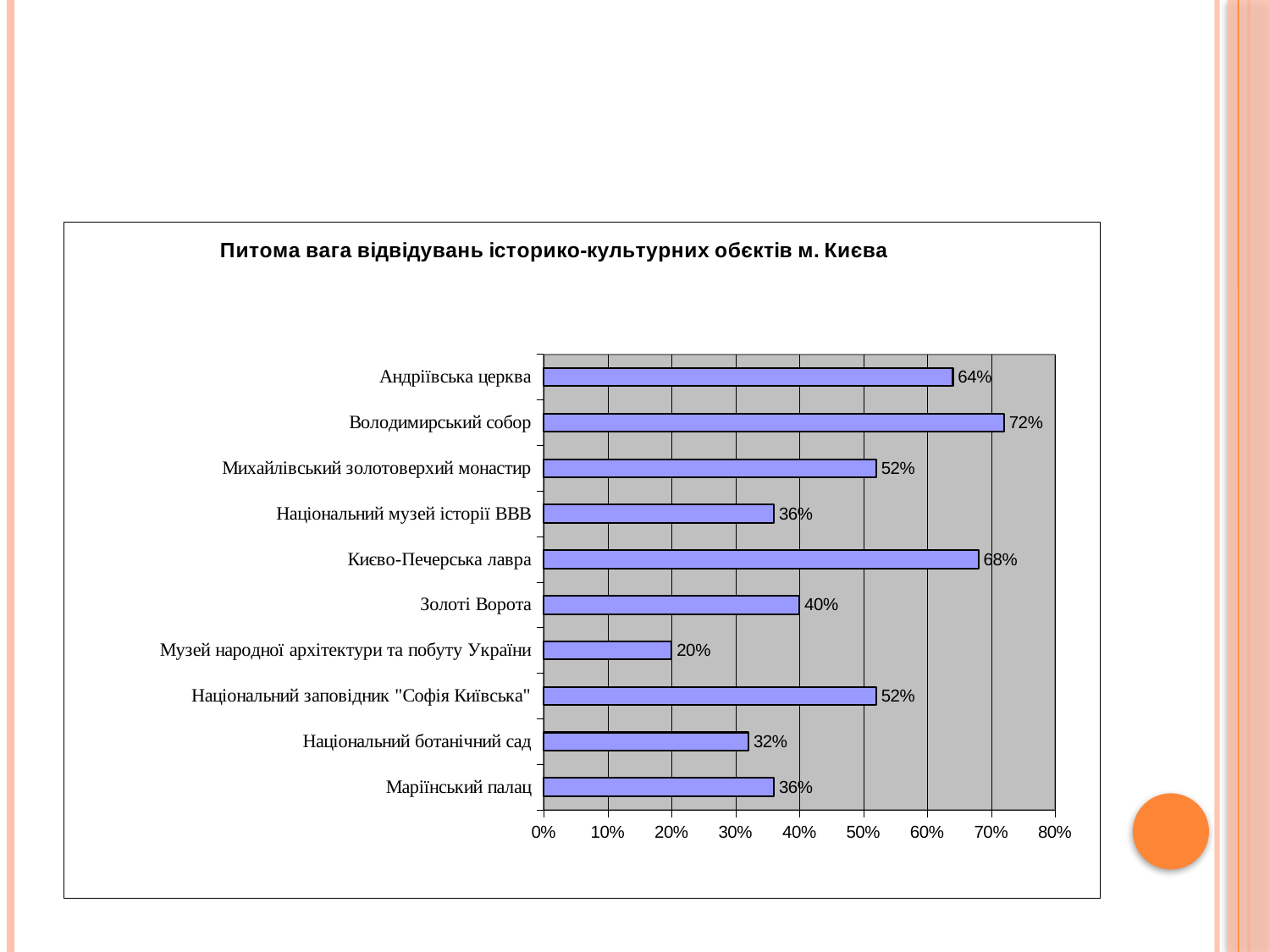
How many categories are shown in the chart? 10 Which is larger, the value for Михайлівський золотоверхий монастир or the value for Національний ботанічний сад? Михайлівський золотоверхий монастир Is the value for Маріїнський палац greater or less than 40%? less What kind of chart is shown on the slide? bar chart What is the value for Києво-Печерська лавра? 68% What is the value for Музей народної архітектури та побуту України? 20% Which category has the lowest value? Музей народної архітектури та побуту України What is the value for Володимирський собор? 72% What is the title of the chart? Питома вага відвідувань історико-культурних обєктів м. Києва Which category has the highest value? Володимирський собор What is the difference between the values for Андріївська церква and Золоті Ворота? 24% What is the value for Національний заповідник "Софія Київська"? 52%